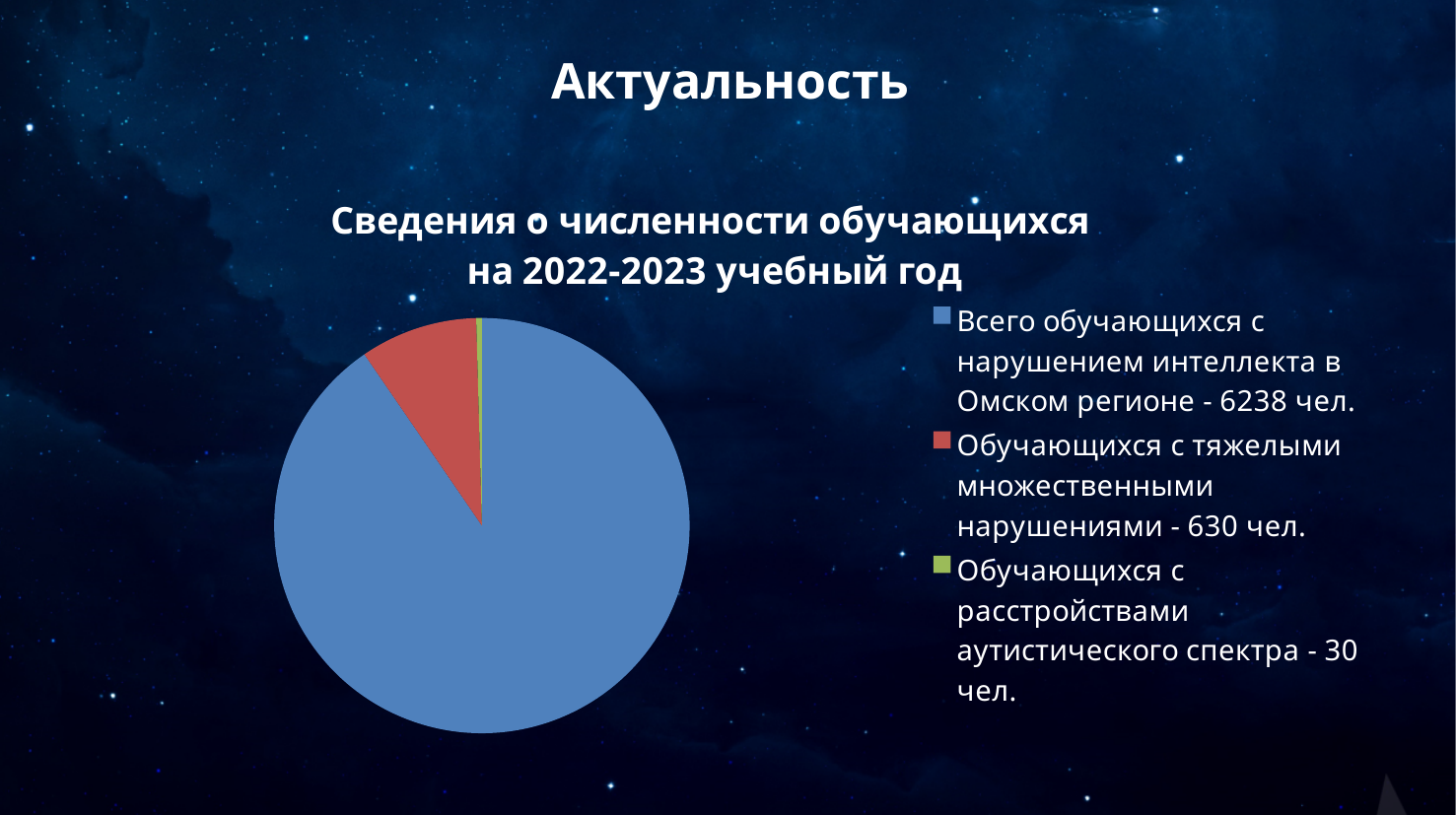
Which is larger: the value for students with severe multiple disabilities or the value for students with autism spectrum disorders? Обучающихся с тяжелыми множественными нарушениями What is the value for "Всего обучающихся с нарушением интеллекта в Омском регионе"? 6238 чел. What is the value for "Обучающихся с тяжелыми множественными нарушениями"? 630 чел. How many entries does the legend of the pie chart list? 3 What is the difference between the number of students with severe multiple disabilities (630) and students with autism spectrum disorders (30)? 600 Which category has the smallest slice of the pie chart? Обучающихся с расстройствами аутистического спектра How many slices does the pie chart have? 3 What is the title of the pie chart? Сведения о численности обучающихся на 2022-2023 учебный год What kind of chart is shown on the slide? pie chart Which category has the largest slice of the pie chart? Всего обучающихся с нарушением интеллекта в Омском регионе What colour is the slice for "Обучающихся с тяжелыми множественными нарушениями"? red What is the value for "Обучающихся с расстройствами аутистического спектра"? 30 чел.